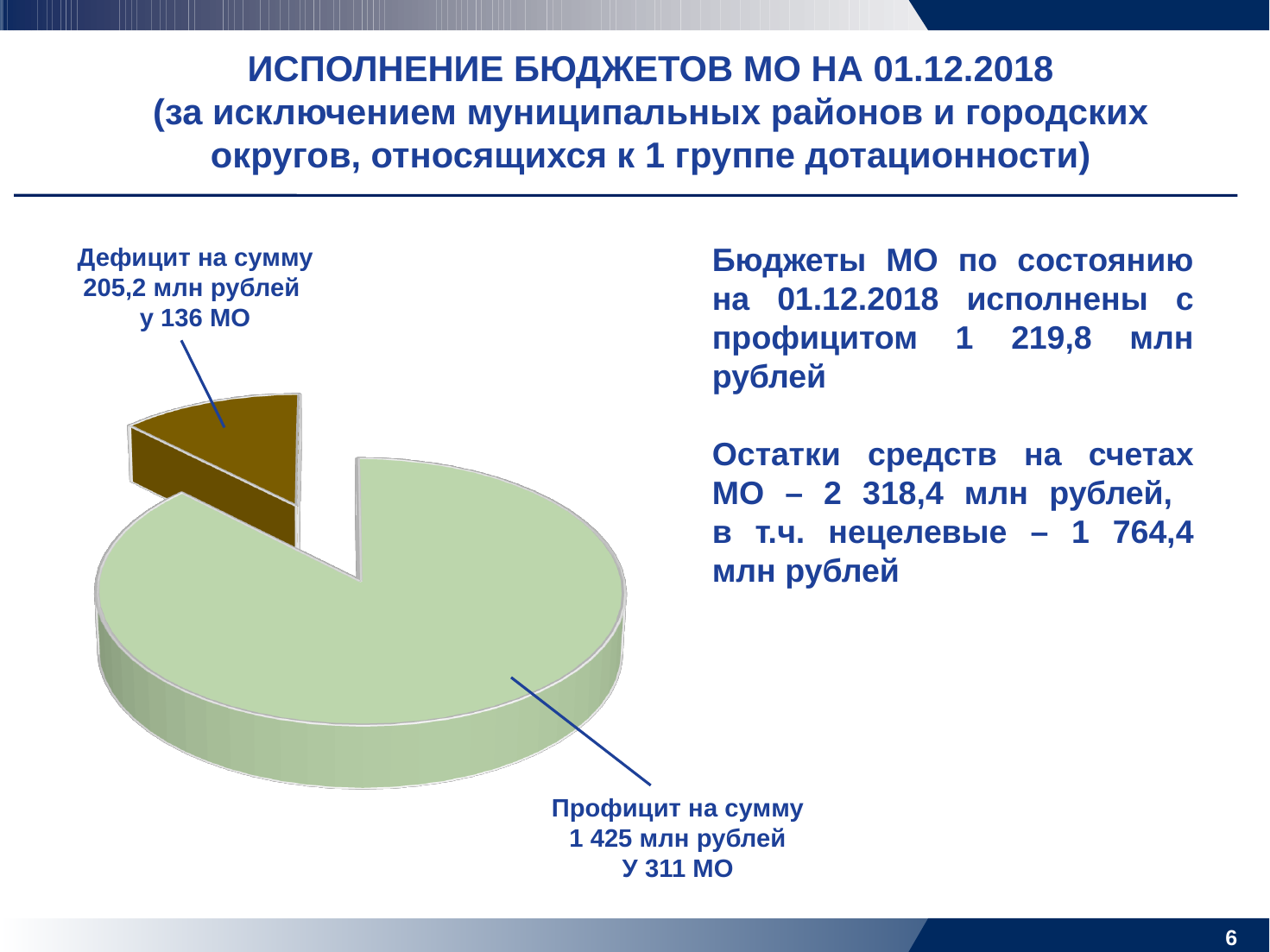
How many slices does the pie chart have? 2 What is the deficit amount shown for the smaller slice of the pie chart? 205,2 млн рублей How many МО are shown as having a deficit in the pie chart? 136 Which is larger in the pie chart: the surplus amount or the deficit amount? the surplus (профицит) What colour is the deficit slice of the pie chart? brown How many МО are shown as having a surplus (профицит) in the pie chart? 311 Which slice of the pie chart is the smallest? Дефицит What kind of chart is shown on the slide? pie chart How many more МО have a surplus than a deficit according to the pie chart labels? 175 What is the surplus (профицит) amount shown for the larger slice of the pie chart? 1 425 млн рублей What is the difference between the surplus amount (1 425 млн рублей) and the deficit amount (205,2 млн рублей) in the pie chart? 1 219,8 млн рублей Which slice of the pie chart is the largest? Профицит